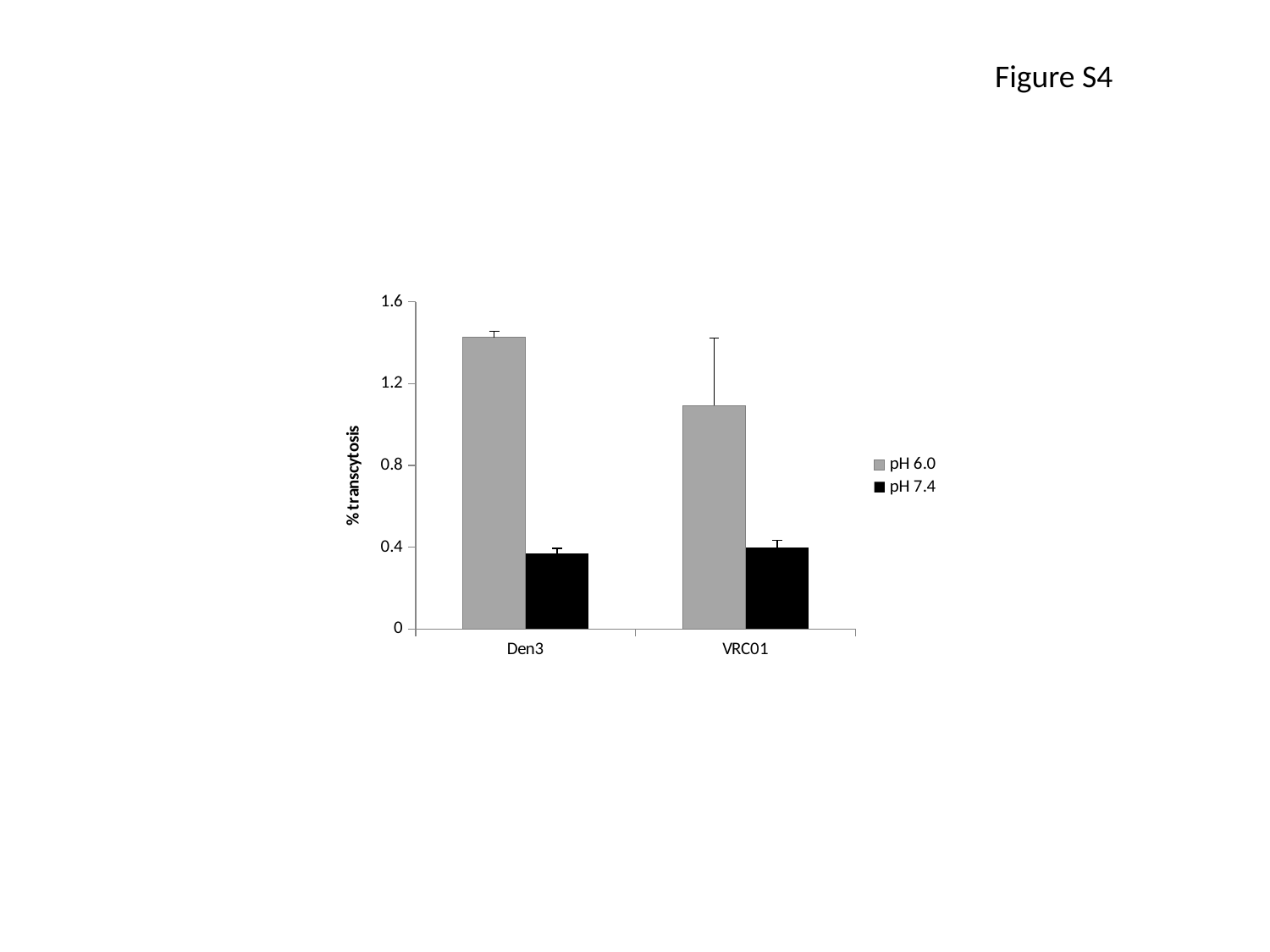
Is the pH 6.0 value for VRC01 greater or less than 0.8? greater Which series has the higher value for Den3, pH 6.0 or pH 7.4? pH 6.0 How many series does the chart's legend list? 2 What kind of chart is shown on the slide? bar chart Which category has the higher pH 6.0 value, Den3 or VRC01? Den3 Which bar is the highest in the chart? Den3 at pH 6.0 Which series is shown in black in the chart? pH 7.4 Is the pH 6.0 value for Den3 greater or less than 1.2? greater Is the pH 7.4 value for VRC01 greater or less than 0.8? less What is the label on the y axis of the chart? % transcytosis How many categories are shown on the x axis of the chart? 2